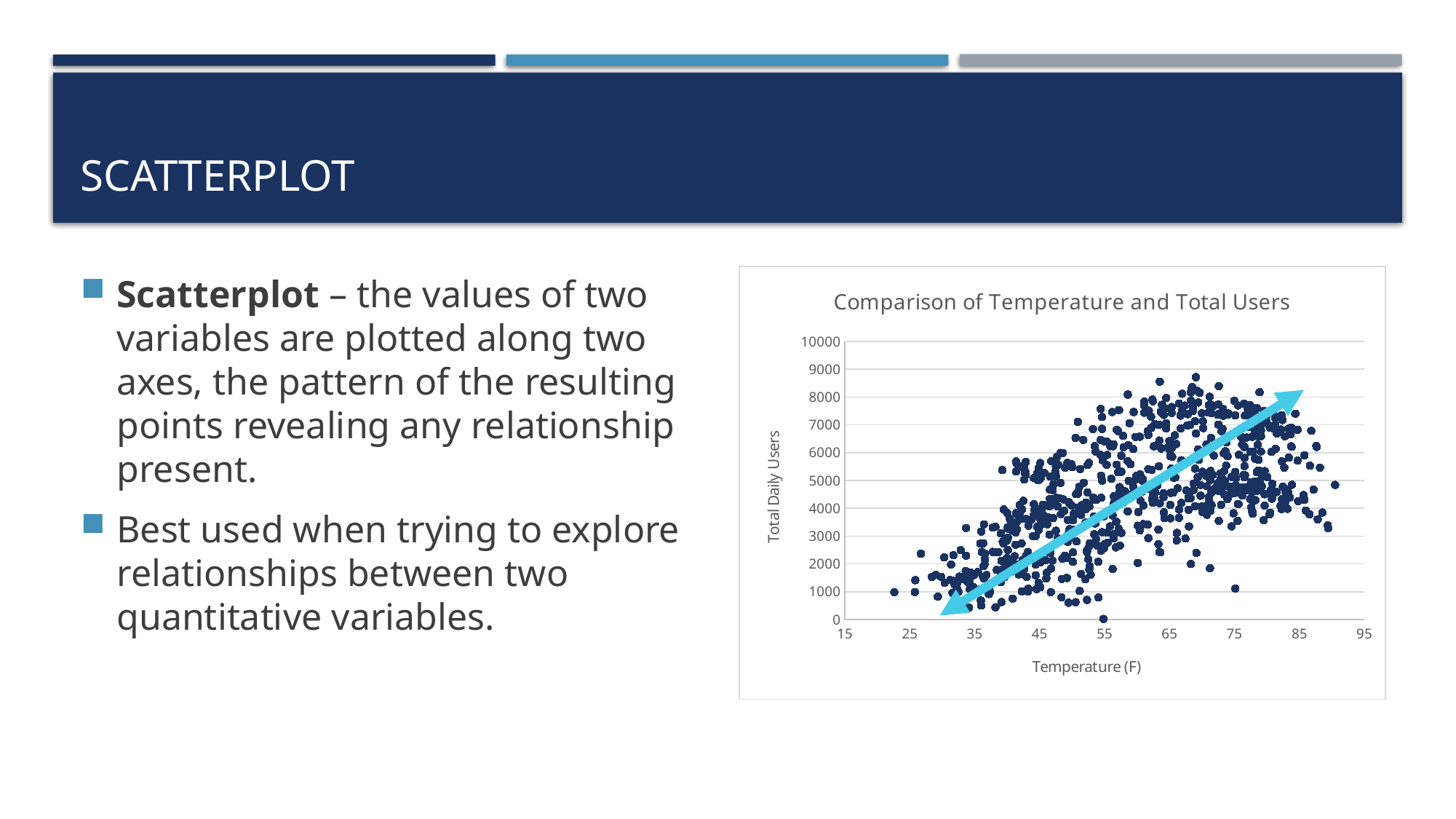
What kind of chart is shown on the slide? Scatter plot What is the highest tick value shown on the y axis of the chart? 10000 What is the label of the x axis of the chart? Temperature (F) What is the lowest tick value shown on the x axis of the chart? 15 Are any points on the chart plotted at a temperature below 15 on the x axis? No What is the title of the chart on the slide? Comparison of Temperature and Total Users As temperature increases along the x axis, do the plotted Total Daily Users values generally rise or fall? Rise What is the spacing between consecutive tick values on the x axis of the chart? 10 Are any points on the chart plotted above 9000 on the y axis? No What is the highest tick value shown on the x axis of the chart? 95 What is the spacing between consecutive tick values on the y axis of the chart? 1000